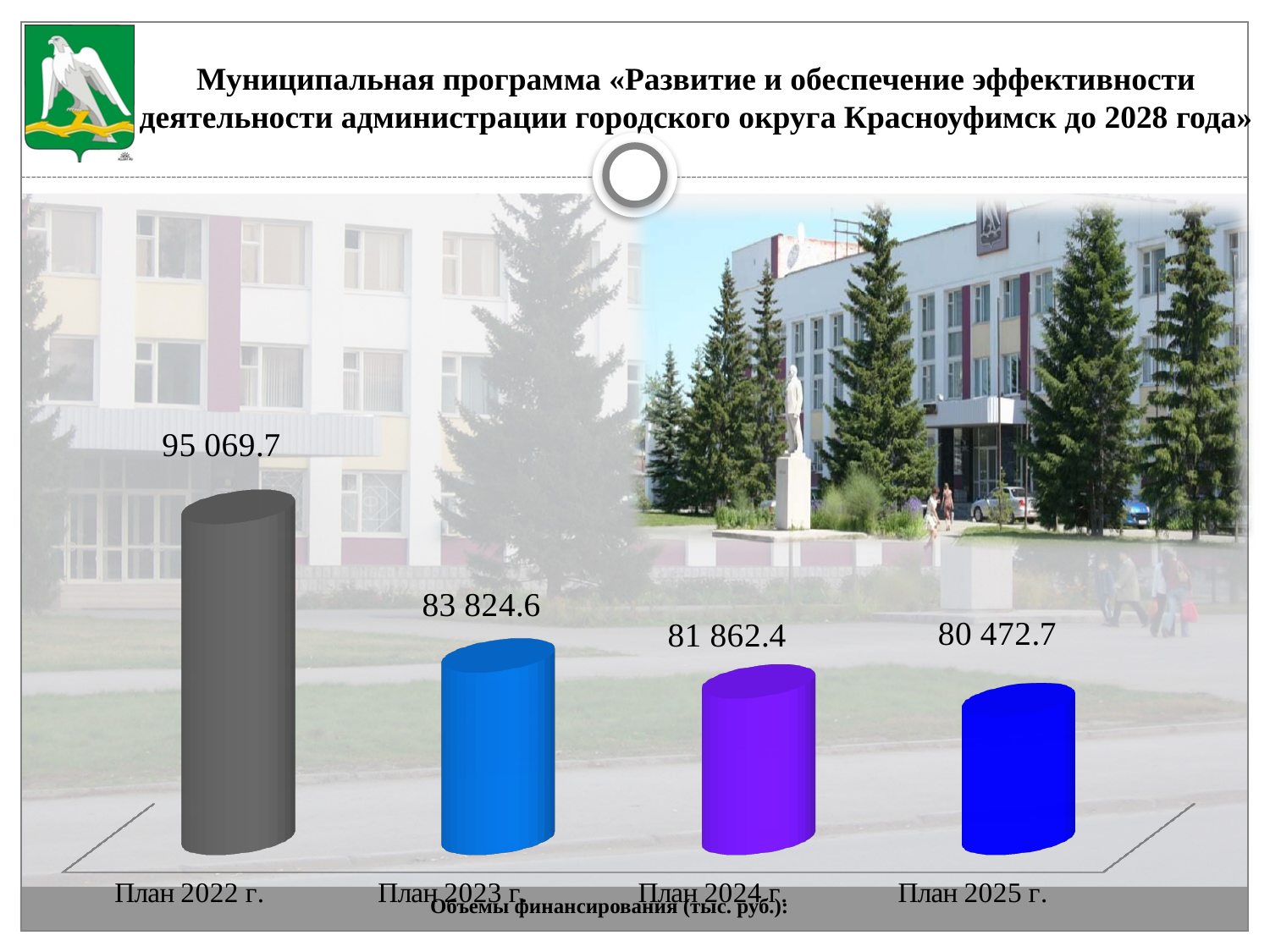
What is the value for План 2024 г.? 81 862.4 What kind of chart is shown on the slide? Bar chart What is the value for План 2022 г.? 95 069.7 Which category has the highest value? План 2022 г. What is the difference between the values for План 2022 г. and План 2023 г.? 11 245.1 What is the value for План 2025 г.? 80 472.7 Which category has the lowest value? План 2025 г. Which is larger, the value for План 2024 г. or the value for План 2025 г.? План 2024 г. What is the difference between the values for План 2022 г. and План 2025 г.? 14 597.0 How many categories are shown on the chart? 4 Do the values rise or fall from План 2022 г. to План 2025 г.? Fall What is the value for План 2023 г.? 83 824.6